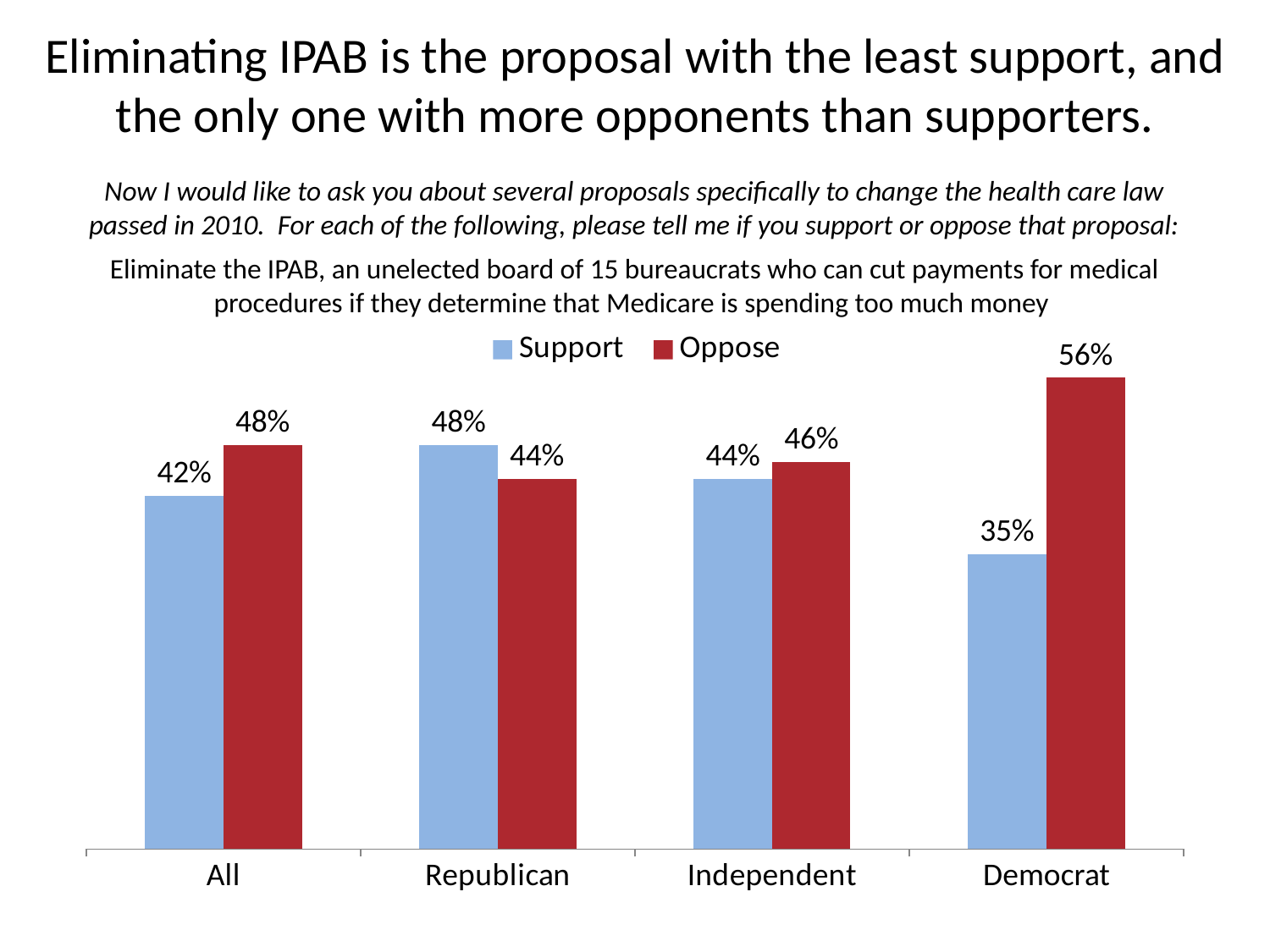
What percentage of Democrats oppose eliminating the IPAB? 56% How many series does the legend list? 2 Which colour represents the Oppose series? Red What kind of chart is shown on the slide? Bar chart What is the difference between the Oppose and Support values for Democrats? 21% For Republicans, which is larger: Support or Oppose? Support What is the Support value for Independents? 44% How many categories are shown on the x axis? 4 Which category has the lowest Support value? Democrat What is the Oppose value for the All category? 48% Which category has the highest Oppose value? Democrat What is the Support value for Republicans? 48%